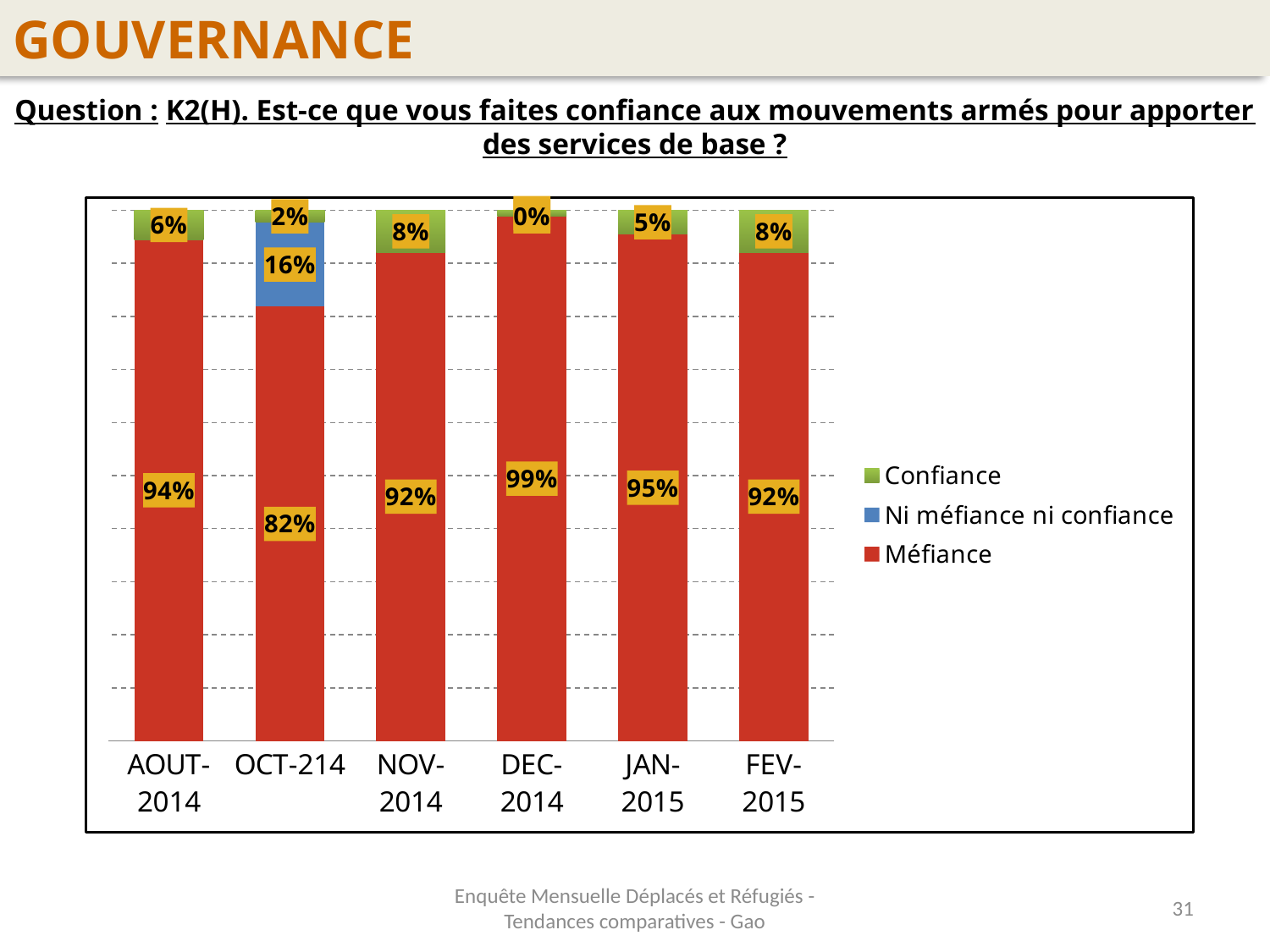
How many categories are shown on the x axis? 6 How many series does the legend list? 3 Which series is shown in red? Méfiance What is the Méfiance value for DEC-2014? 99% What is the difference between the Méfiance values for DEC-2014 and OCT-214? 17% What type of chart is shown on the slide? stacked bar chart What is the Méfiance value for OCT-214? 82% Which is larger, the Confiance value for AOUT-2014 or for NOV-2014? NOV-2014 What is the Ni méfiance ni confiance value for OCT-214? 16% Which category has the lowest Méfiance value? OCT-214 What is the Confiance value for JAN-2015? 5% Which category has the highest Méfiance value? DEC-2014